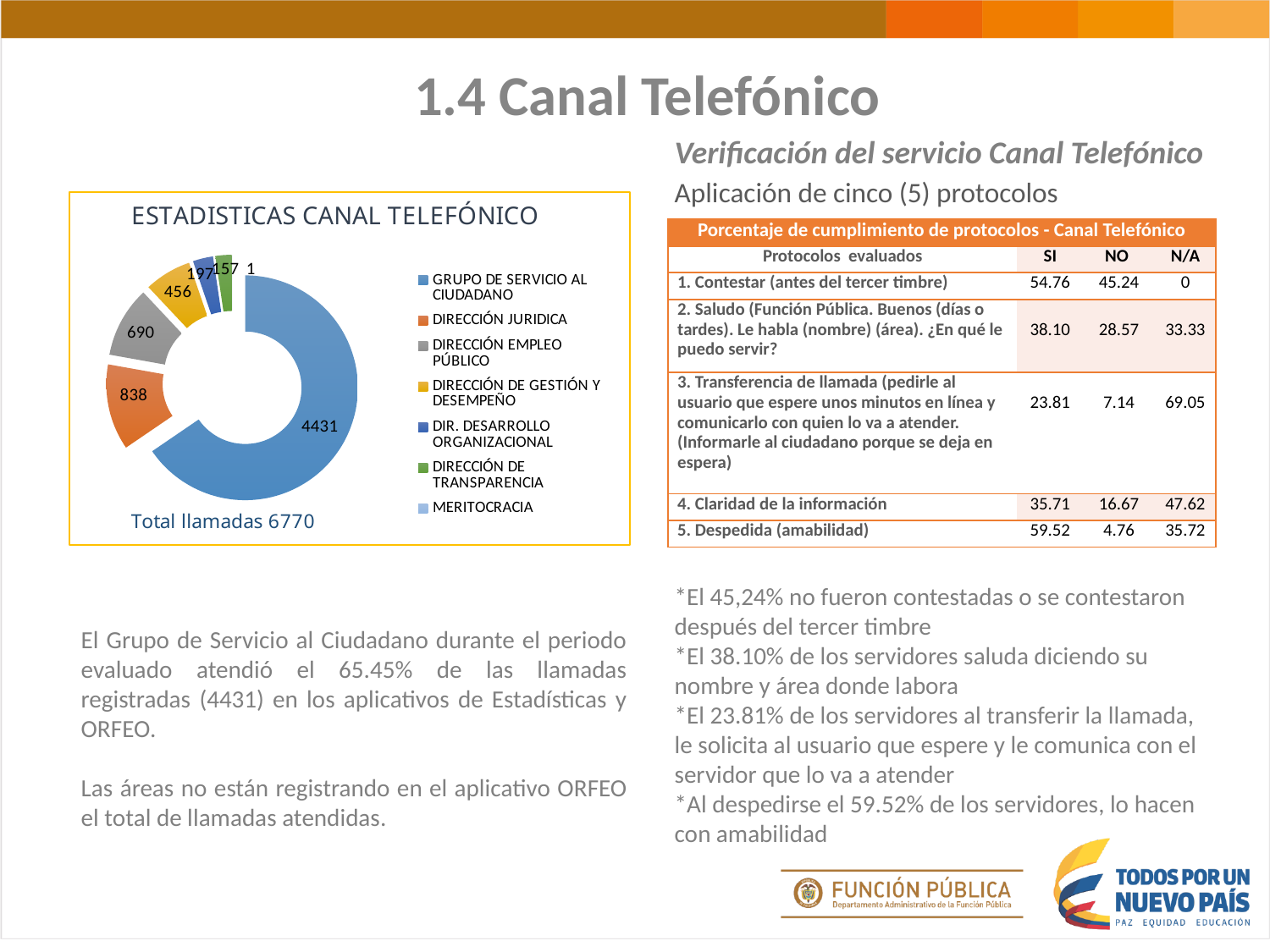
In the ESTADISTICAS CANAL TELEFÓNICO chart, what is the value for DIRECCIÓN DE GESTIÓN Y DESEMPEÑO? 456 Which category has the smallest value in the ESTADISTICAS CANAL TELEFÓNICO chart? MERITOCRACIA What type of chart is shown under the title ESTADISTICAS CANAL TELEFÓNICO? Doughnut chart In the ESTADISTICAS CANAL TELEFÓNICO chart, what is the difference between the values for DIRECCIÓN JURIDICA and DIRECCIÓN EMPLEO PÚBLICO? 148 In the ESTADISTICAS CANAL TELEFÓNICO chart, what is the value for DIRECCIÓN EMPLEO PÚBLICO? 690 In the ESTADISTICAS CANAL TELEFÓNICO chart, what is the value for DIRECCIÓN JURIDICA? 838 In the ESTADISTICAS CANAL TELEFÓNICO chart, what colour is the segment for DIRECCIÓN DE TRANSPARENCIA? Green In the ESTADISTICAS CANAL TELEFÓNICO chart, what is the value for GRUPO DE SERVICIO AL CIUDADANO? 4431 How many categories does the legend of the ESTADISTICAS CANAL TELEFÓNICO chart list? 7 What total number of calls is stated below the ESTADISTICAS CANAL TELEFÓNICO chart? Total llamadas 6770 Which category has the largest value in the ESTADISTICAS CANAL TELEFÓNICO chart? GRUPO DE SERVICIO AL CIUDADANO In the ESTADISTICAS CANAL TELEFÓNICO chart, which is larger: DIRECCIÓN DE GESTIÓN Y DESEMPEÑO or DIRECCIÓN EMPLEO PÚBLICO? DIRECCIÓN EMPLEO PÚBLICO